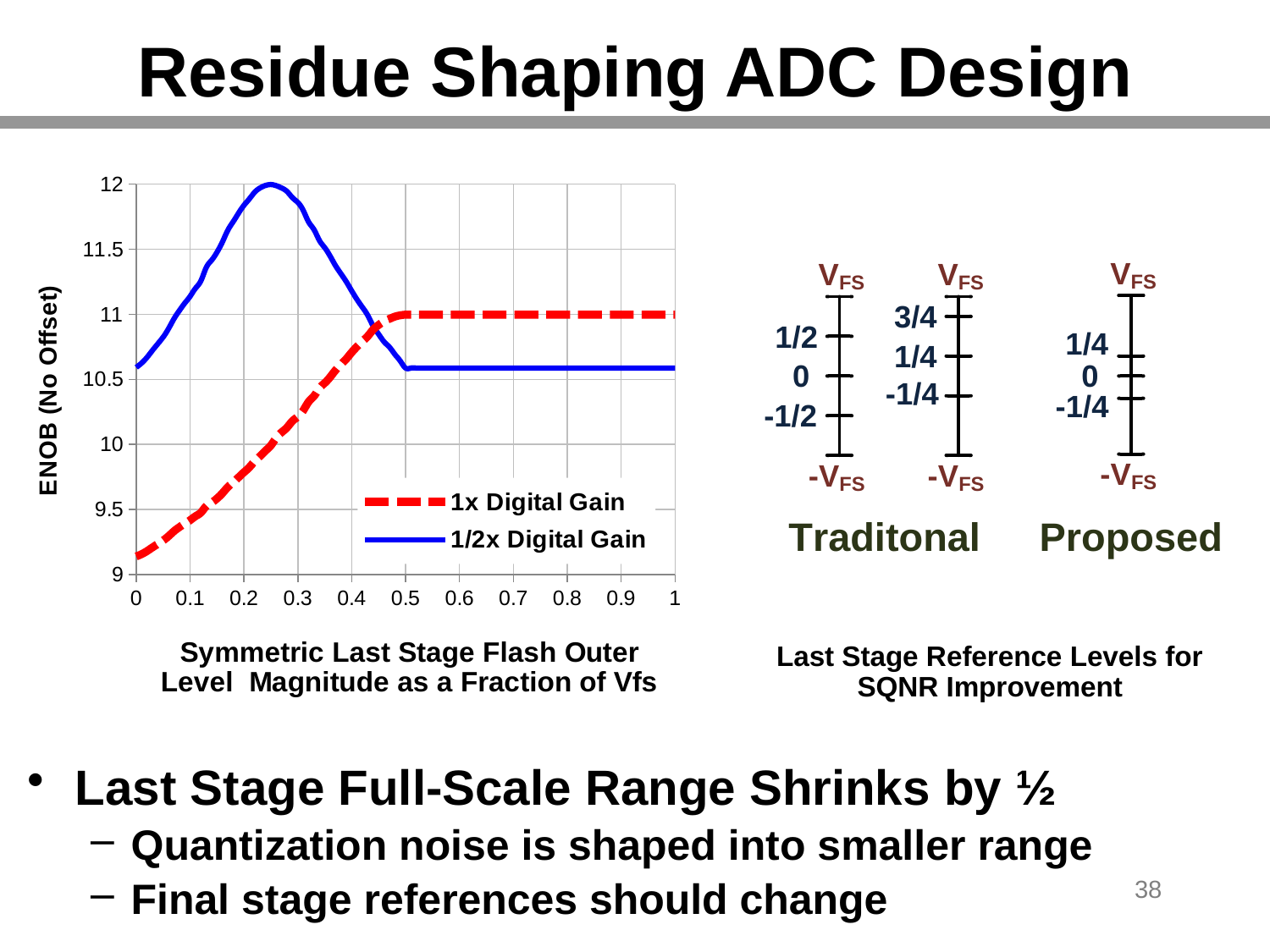
What are the two series named in the legend of the ENOB chart? 1x Digital Gain and 1/2x Digital Gain Is the ENOB of the 1/2x Digital Gain series at x = 0.8 greater or less than 11? less At x = 0, which series has the higher ENOB, 1x Digital Gain or 1/2x Digital Gain? 1/2x Digital Gain How does the 1x Digital Gain series behave as x increases from 0 to 1? rises until about 0.5, then stays flat What is the y-axis title of the line chart? ENOB (No Offset) Is the ENOB of the 1/2x Digital Gain series at x = 0.2 greater or less than 11.5? greater What kind of chart is shown on the left of the slide? line chart At x = 1, which series has the higher ENOB, 1x Digital Gain or 1/2x Digital Gain? 1x Digital Gain What is the peak ENOB value reached by the 1/2x Digital Gain series? 12 Is the ENOB of the 1x Digital Gain series at x = 0 greater or less than 9.5? less What ENOB value does the 1x Digital Gain series level off at for x from 0.5 to 1? 11 How many series does the legend of the ENOB chart list? 2